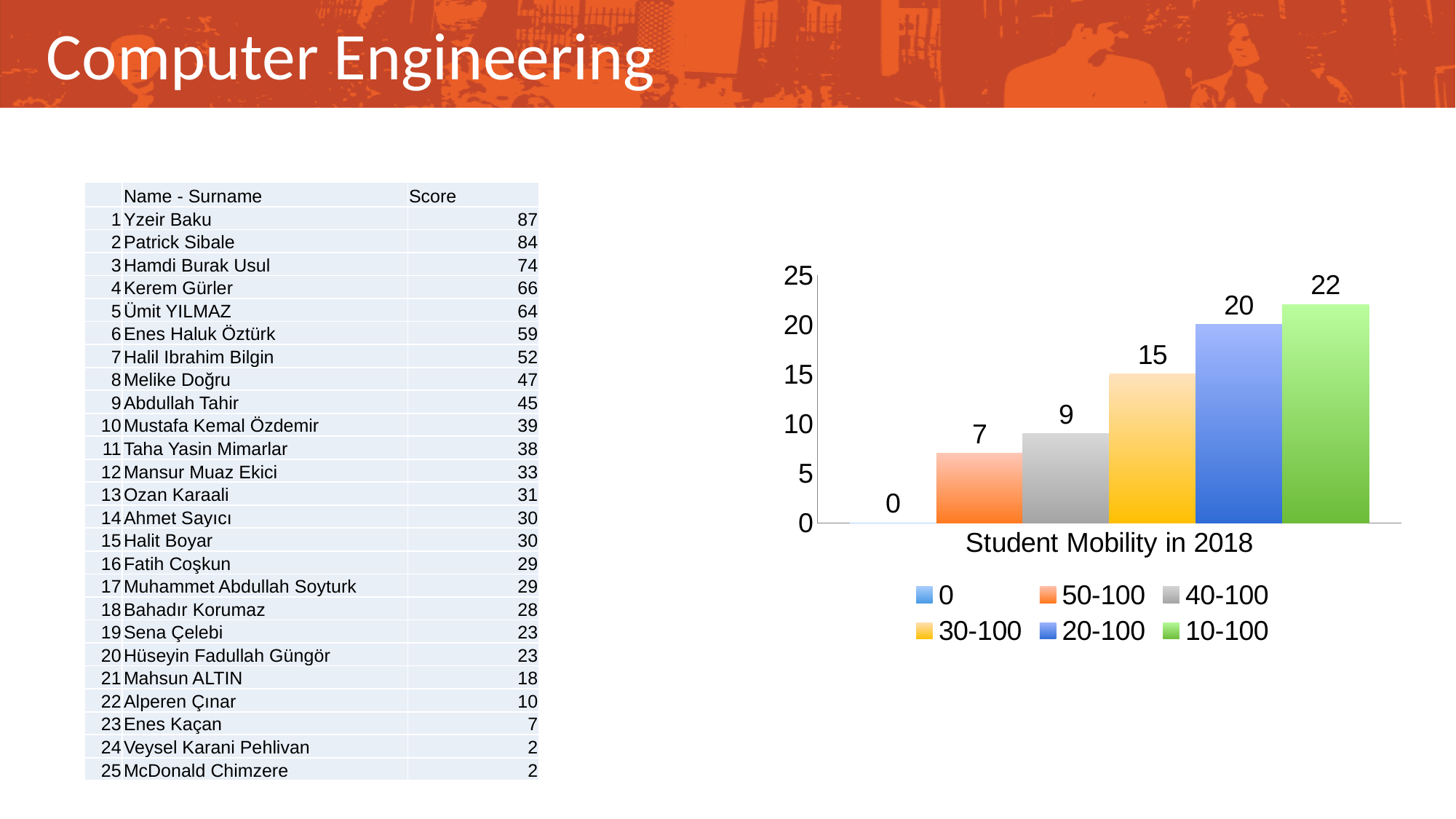
What kind of chart is the Student Mobility in 2018 chart? bar chart What is the value for the 10-100 series in the Student Mobility in 2018 chart? 22 What is the category label shown below the bars in the chart? Student Mobility in 2018 How many series does the legend of the Student Mobility in 2018 chart list? 6 Do the bar values rise or fall from left to right in the Student Mobility in 2018 chart? rise What is the value for the 40-100 series in the Student Mobility in 2018 chart? 9 What is the value for the 30-100 series in the Student Mobility in 2018 chart? 15 What is the difference between the values for the 20-100 and 50-100 series in the Student Mobility in 2018 chart? 13 Which series has the lowest value in the Student Mobility in 2018 chart? 0 What is the value for the 50-100 series in the Student Mobility in 2018 chart? 7 Which is larger in the Student Mobility in 2018 chart, the value for 30-100 or the value for 40-100? 30-100 Which series has the highest value in the Student Mobility in 2018 chart? 10-100